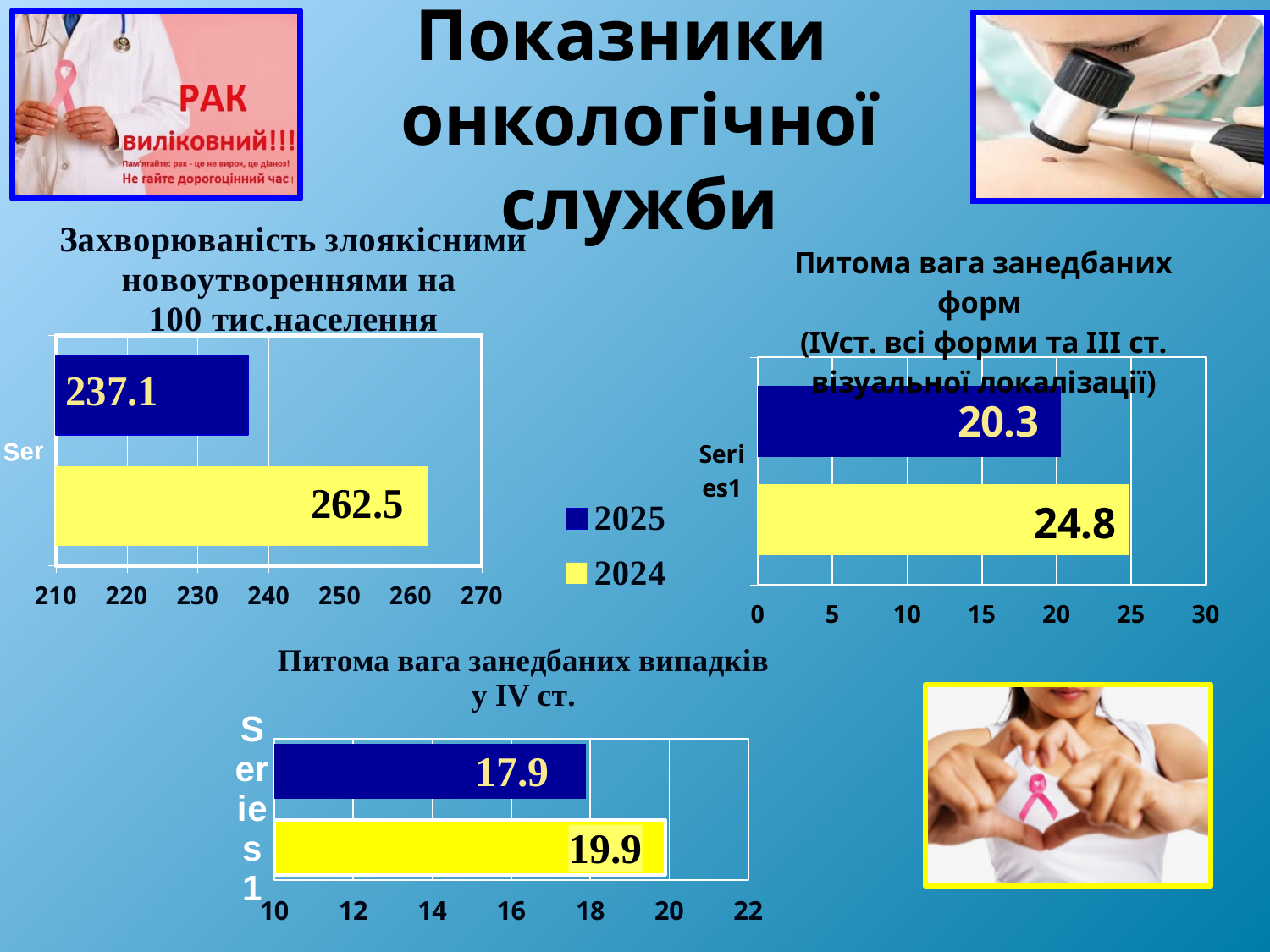
In the chart titled 'Питома вага занедбаних форм', what is the value shown on the yellow bar? 24.8 What kind of chart is the one titled 'Питома вага занедбаних випадків у IV ст.'? bar chart In the chart titled 'Захворюваність злоякісними новоутвореннями на 100 тис.населення', what is the value for 2025 (blue bar)? 237.1 In the chart titled 'Питома вага занедбаних випадків у IV ст.', which bar is larger, the blue bar or the yellow bar? yellow bar In the chart titled 'Питома вага занедбаних форм', what is the difference between the yellow bar and the blue bar? 4.5 In the chart titled 'Захворюваність злоякісними новоутвореннями на 100 тис.населення', which year has the larger value, 2024 or 2025? 2024 In the chart titled 'Питома вага занедбаних форм', what is the value shown on the blue bar? 20.3 In the chart titled 'Захворюваність злоякісними новоутвореннями на 100 тис.населення', what is the value for 2024 (yellow bar)? 262.5 How many entries does the legend next to the chart titled 'Захворюваність злоякісними новоутвореннями на 100 тис.населення' list? 2 In the chart titled 'Питома вага занедбаних випадків у IV ст.', what is the value shown on the blue bar? 17.9 In the chart titled 'Захворюваність злоякісними новоутвореннями на 100 тис.населення', what is the difference between the 2024 and 2025 values? 25.4 In the chart titled 'Питома вага занедбаних випадків у IV ст.', what is the value shown on the yellow bar? 19.9